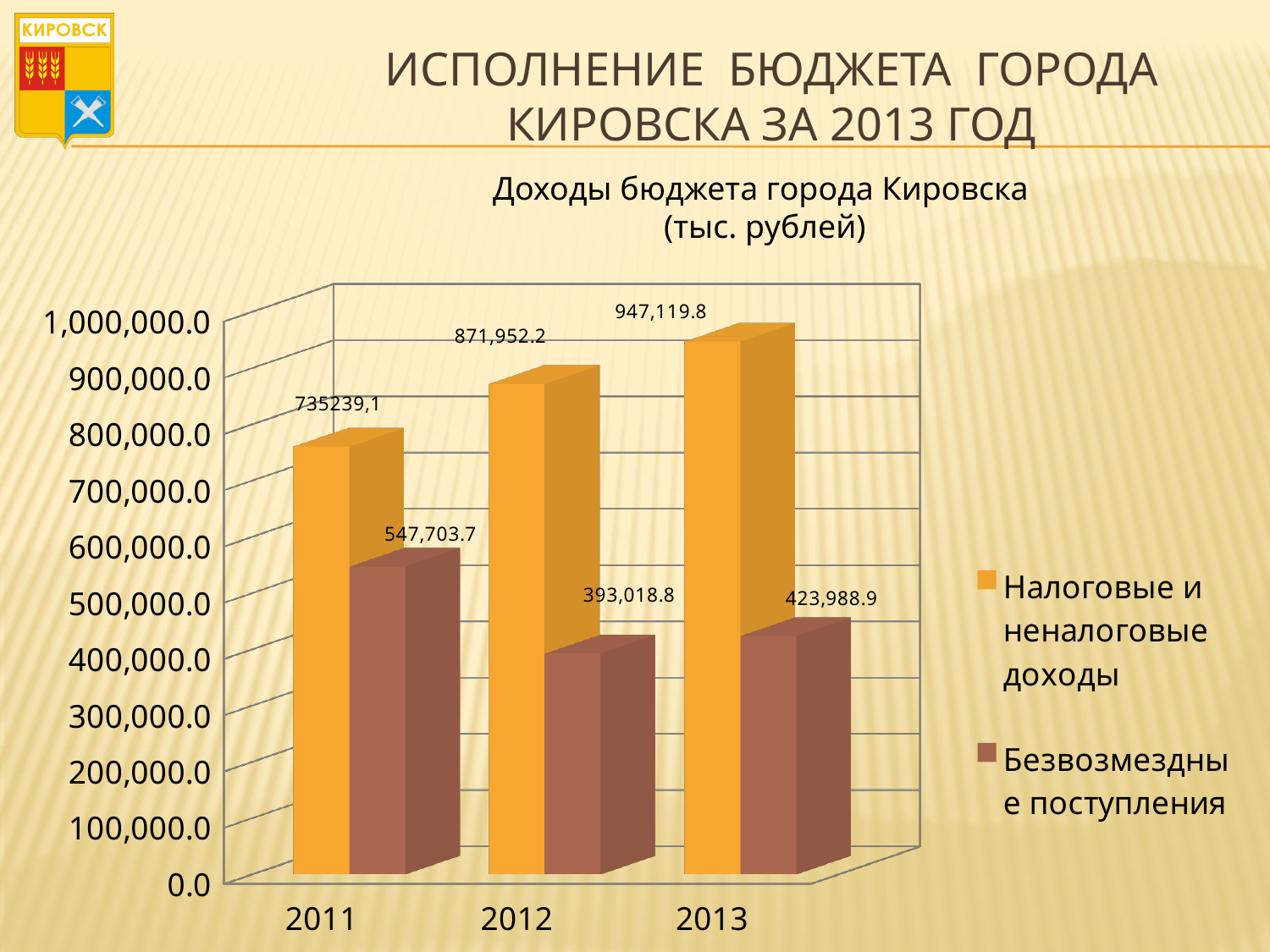
What is the value for Безвозмездные поступления in 2012? 393,018.8 What is the value for Безвозмездные поступления in 2013? 423,988.9 What kind of chart is shown on the slide? Bar chart What is the value for Налоговые и неналоговые доходы in 2013? 947,119.8 Which is larger: Безвозмездные поступления in 2012 or in 2013? 2013 How many series does the legend list? 2 How many years are shown on the x axis? 3 In which year were Безвозмездные поступления highest? 2011 What is the difference between Безвозмездные поступления in 2011 and in 2012? 154,684.9 What is the value for Налоговые и неналоговые доходы in 2011? 735239,1 What is the difference between Налоговые и неналоговые доходы in 2013 and in 2012? 75,167.6 In which year were Налоговые и неналоговые доходы lowest? 2011